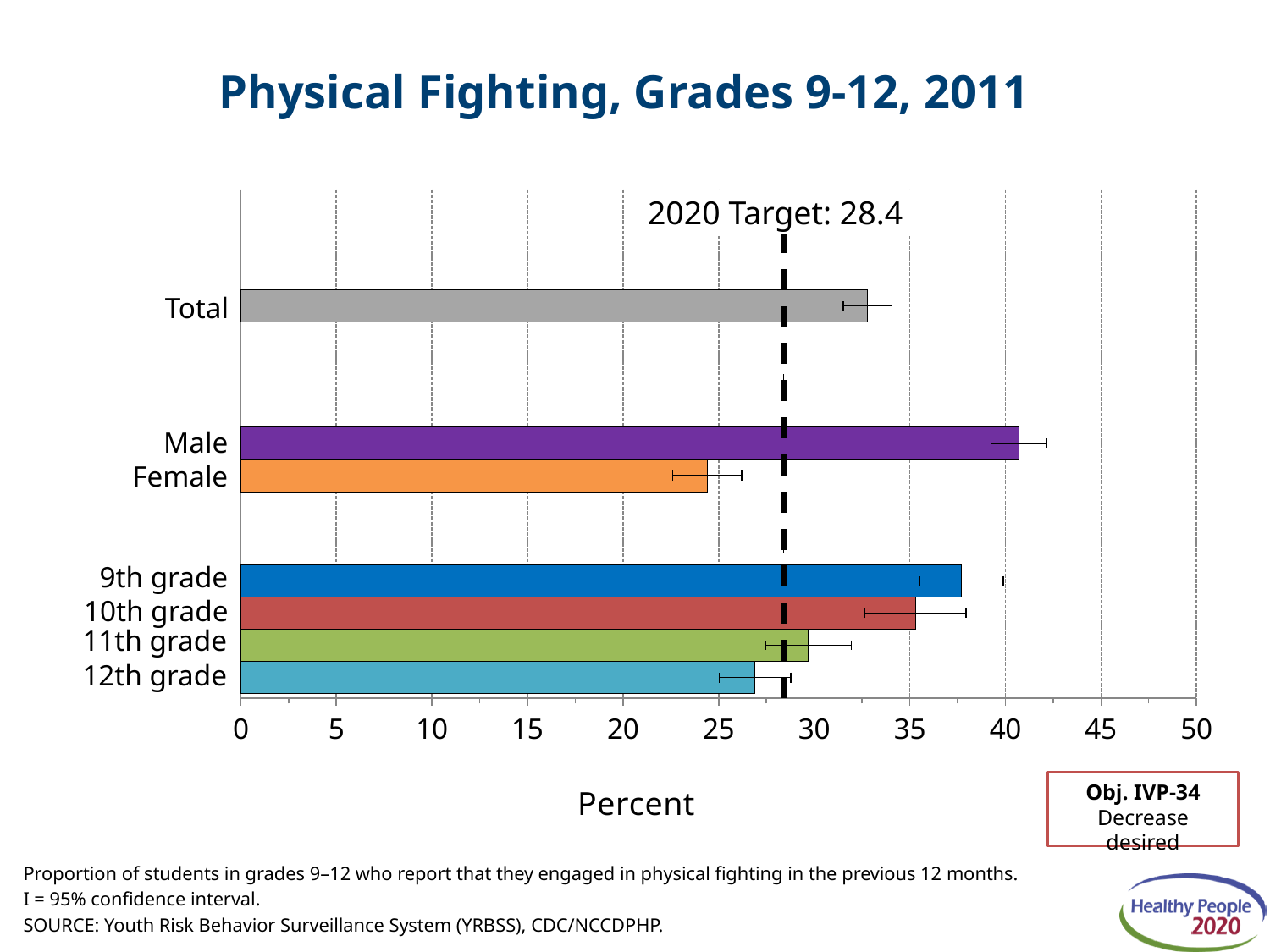
Among the grade categories, which grade has the highest value? 9th grade What kind of chart is shown on the slide? Bar chart Which category has the lowest value? Female How many bars (categories) are plotted on the chart? 7 Is the value for 12th grade greater or less than 30? less What is the label of the horizontal axis? Percent Among the grade categories, which grade has the lowest value? 12th grade What is the 2020 Target value shown on the chart? 28.4 Which is larger, the value for Male or the value for Female? Male Which category has the highest value? Male Which is larger, the value for 10th grade or the value for 11th grade? 10th grade Is the value for Male greater or less than 35? greater